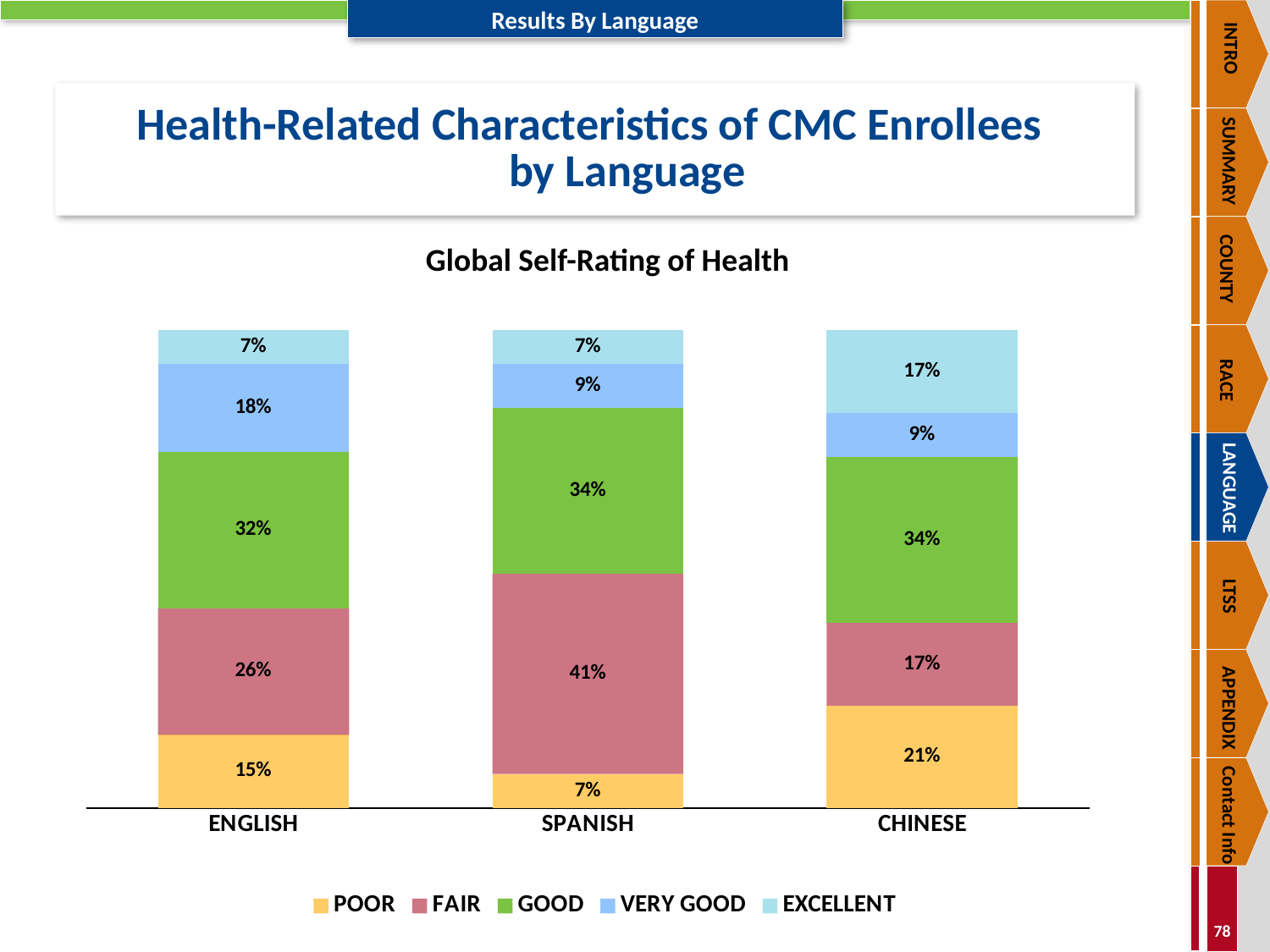
What is the Fair percentage for Spanish enrollees? 41% What type of chart is shown on the slide? stacked bar chart What is the title of the chart? Global Self-Rating of Health Which language group has the highest Fair percentage? Spanish What is the difference between the Fair percentage for Spanish and the Fair percentage for Chinese? 24% Which language group has the lowest Poor percentage? Spanish How many language groups are shown on the x axis? 3 What is the Very Good percentage for English enrollees? 18% What is the Poor percentage for Chinese enrollees? 21% How many series does the legend list? 5 What is the Excellent percentage for Chinese enrollees? 17% Is the Good percentage larger for English or for Spanish enrollees? Spanish